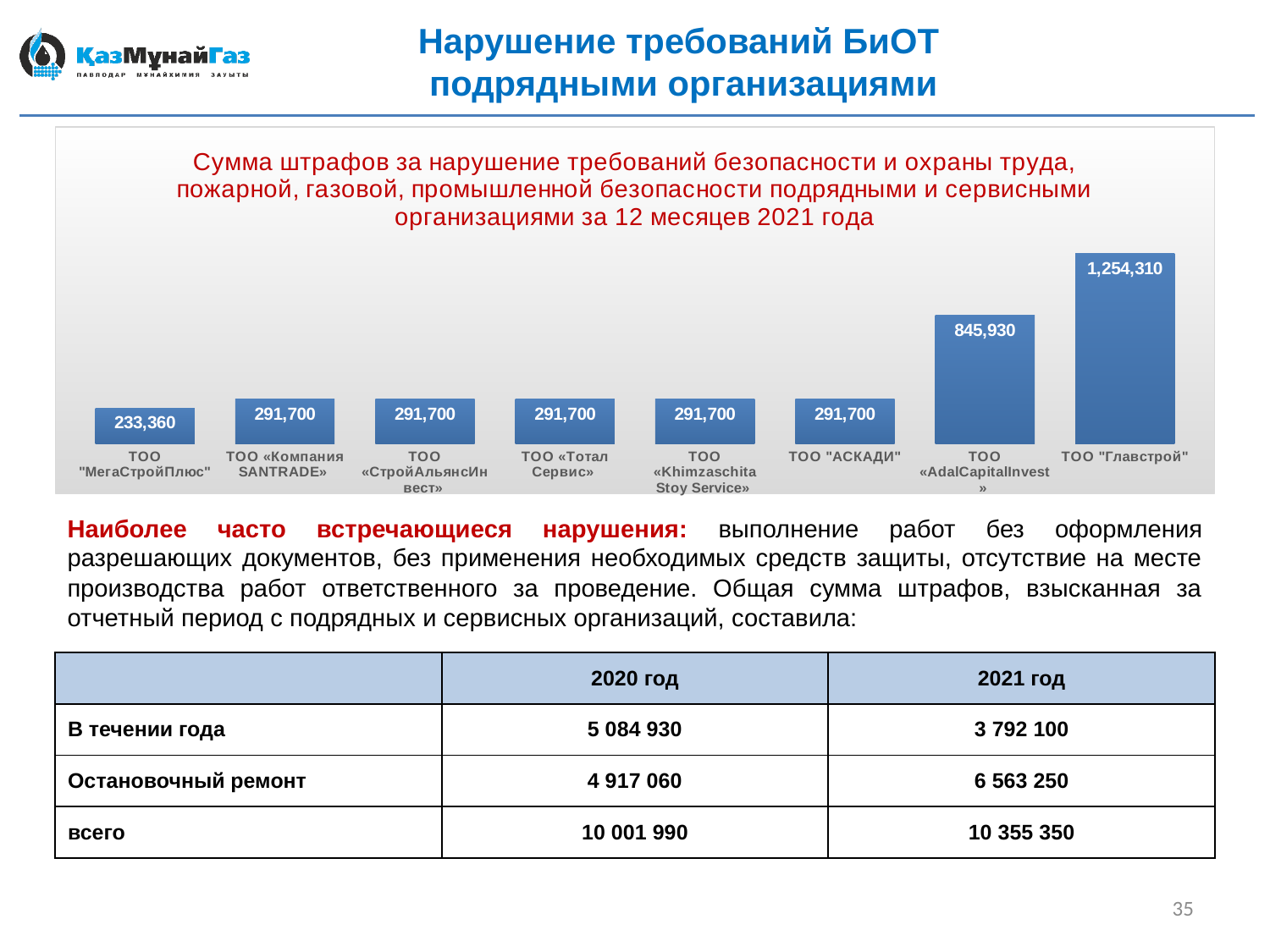
How many organisations are shown in the chart? 8 Do the values rise or fall from left to right across the chart? Rise Which organisation has the lowest fine amount? ТОО "МегаСтройПлюс" What is the value for ТОО "МегаСтройПлюс"? 233,360 Which organisation has the highest fine amount? ТОО "Главстрой" What is the difference between the values for ТОО «Тотал Сервис» and ТОО "МегаСтройПлюс"? 58,340 What is the difference between the values for ТОО "Главстрой" and ТОО «AdalCapitalInvest»? 408,380 What is the value for ТОО "АСКАДИ"? 291,700 What is the value for ТОО «AdalCapitalInvest»? 845,930 What kind of chart is shown on the slide? Bar chart What is the value for ТОО "Главстрой"? 1,254,310 Which is larger, the value for ТОО «AdalCapitalInvest» or the value for ТОО «Компания SANTRADE»? ТОО «AdalCapitalInvest»